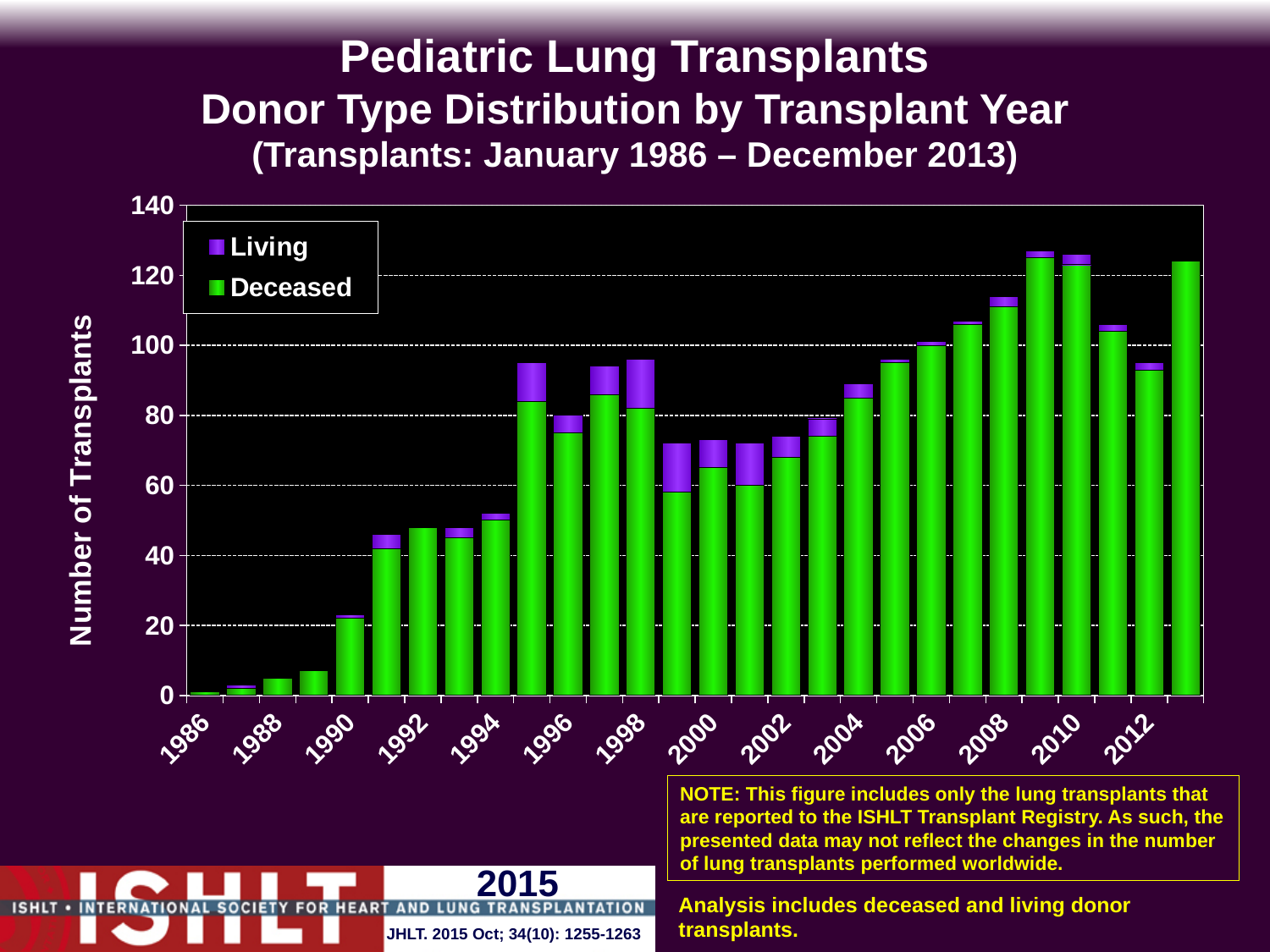
Did the total number of transplants generally rise or fall from 2003 to 2009? Rise How many series does the legend list? 2 Which year had more total transplants, 2009 or 2012? 2009 Is the total number of transplants in 2008 greater or less than 100? greater Is the total number of transplants in 2012 greater or less than 100? less Is the total number of transplants in 2000 greater or less than 80? less Which year has the lowest total number of transplants? 1986 What are the two donor types listed in the legend? Living and Deceased Which colour represents Deceased donors in the chart? Green What kind of chart is shown on the slide? Stacked bar chart